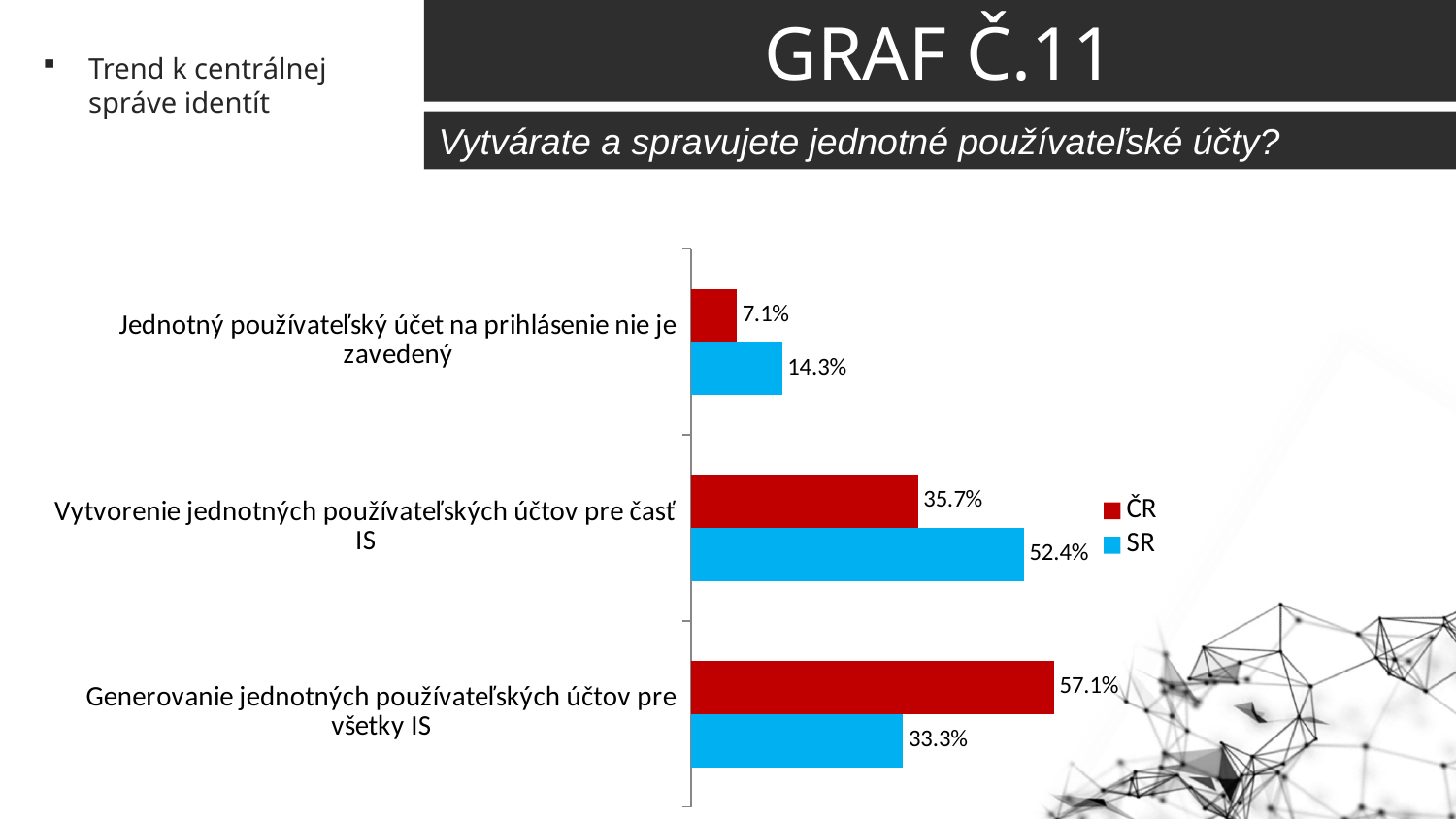
For "Generovanie jednotných používateľských účtov pre všetky IS", which series has the larger value, ČR or SR? ČR Which category has the highest ČR value? Generovanie jednotných používateľských účtov pre všetky IS Which colour represents the SR series in the legend? Blue What is the SR value for "Jednotný používateľský účet na prihlásenie nie je zavedený"? 14.3% What is the difference between the SR and ČR values for "Vytvorenie jednotných používateľských účtov pre časť IS"? 16.7% What kind of chart is shown on the slide? Bar chart How many categories are shown on the chart? 3 Which category has the lowest SR value? Jednotný používateľský účet na prihlásenie nie je zavedený What is the SR value for "Vytvorenie jednotných používateľských účtov pre časť IS"? 52.4% What is the ČR value for "Jednotný používateľský účet na prihlásenie nie je zavedený"? 7.1% How many series does the legend list? 2 What is the ČR value for "Generovanie jednotných používateľských účtov pre všetky IS"? 57.1%